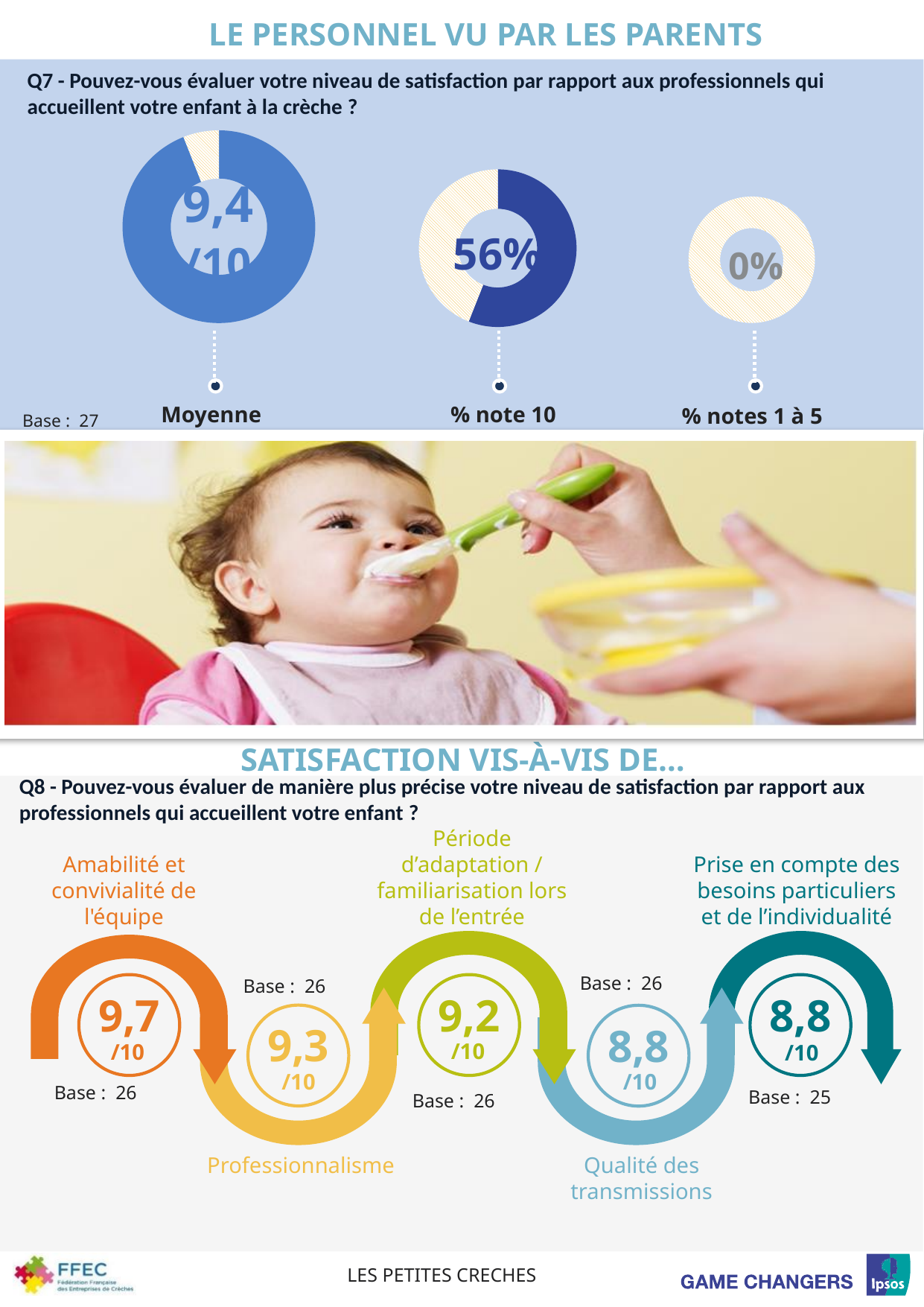
In the Q7 section, which is larger: the '% note 10' value or the '% notes 1 à 5' value? % note 10 How many donut charts are shown in the Q7 section of the slide? 3 What kind of chart is used to display the Q7 results? Donut chart In the Q8 section, what is the base indicated for 'Prise en compte des besoins particuliers et de l'individualité'? 25 In the Q8 section, what score is given for 'Amabilité et convivialité de l'équipe'? 9,7/10 In the Q7 section, what percentage is shown in the '% notes 1 à 5' donut chart? 0% In the Q7 section, what is the value shown in the 'Moyenne' donut chart? 9,4/10 In the Q8 section, what score is given for 'Professionnalisme'? 9,3/10 In the Q8 section, which item has the highest score? Amabilité et convivialité de l'équipe In the Q7 section, what is the difference between the '% note 10' value and the '% notes 1 à 5' value? 56% What is the base (number of respondents) indicated for the Q7 charts? 27 In the Q7 section, what percentage is shown in the '% note 10' donut chart? 56%